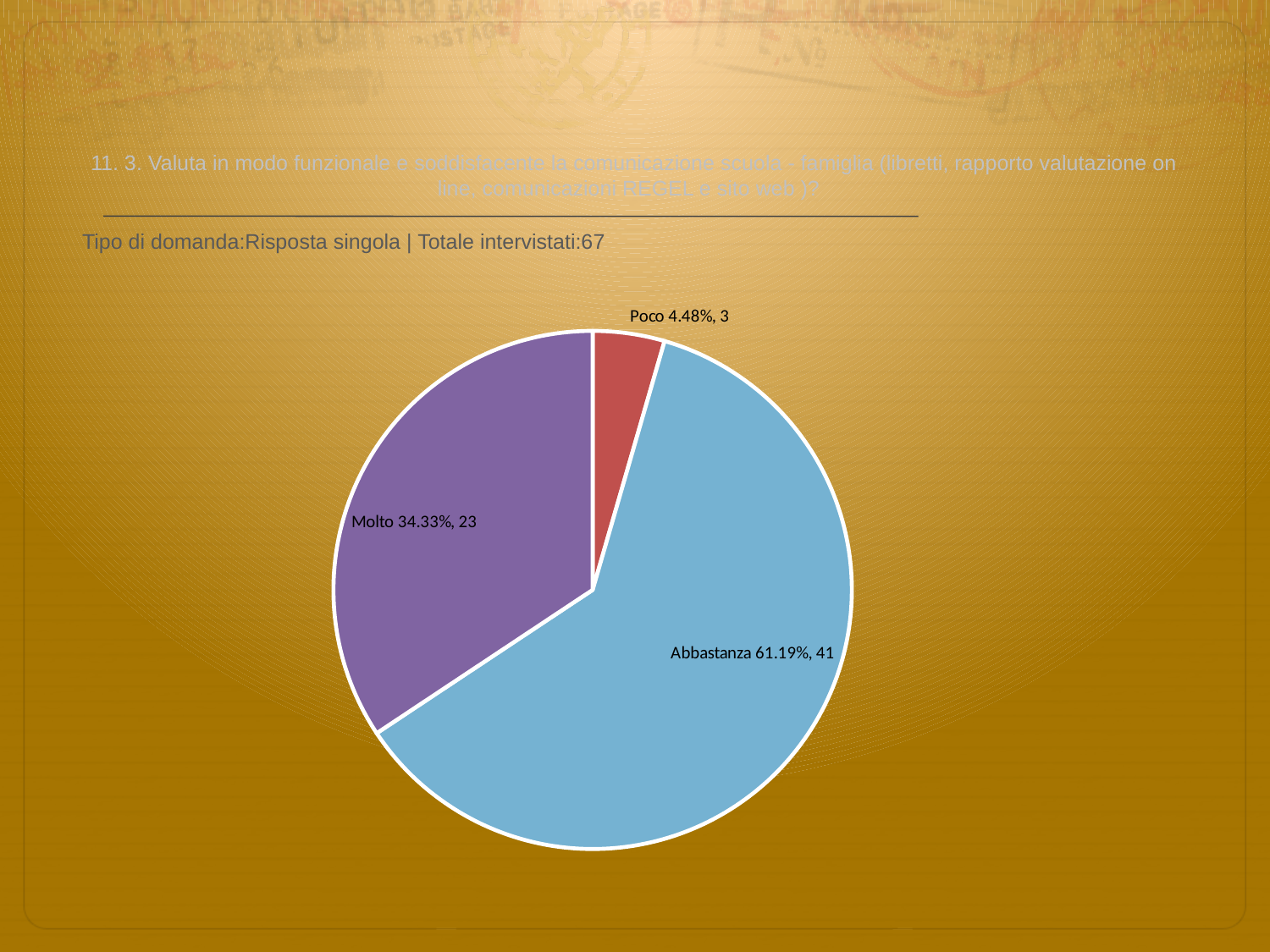
How many respondents answered Abbastanza? 41 What kind of chart is shown on the slide? pie chart How many slices does the pie chart have? 3 Which category has the smallest slice? Poco Which category has the largest slice? Abbastanza What percentage share does the Molto slice have? 34.33% What percentage share does the Poco slice have? 4.48% How many respondents answered Molto? 23 What is the difference in respondent count between Abbastanza and Molto? 18 How many respondents answered Poco? 3 What percentage share does the Abbastanza slice have? 61.19% Which is larger, the Molto slice or the Poco slice? Molto